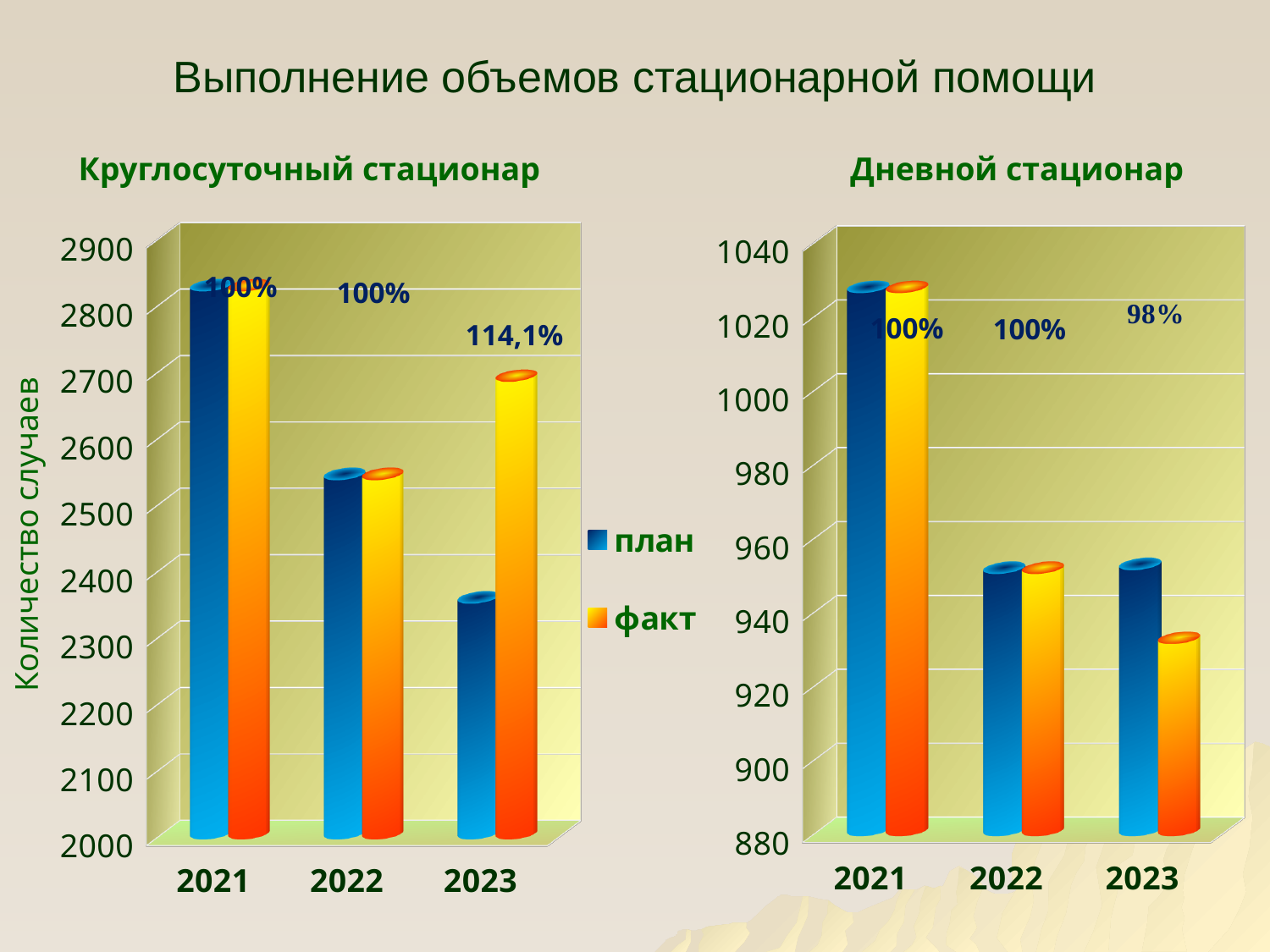
In the "Дневной стационар" chart, how many years are shown on the x axis? 3 In the "Круглосуточный стационар" chart, for 2023, which is larger: план or факт? факт What kind of chart is the "Круглосуточный стационар" chart? bar chart In the "Круглосуточный стационар" chart, which year has the lowest план value? 2023 In the "Круглосуточный стационар" chart, does the план value rise or fall from 2021 to 2023? fall In the "Дневной стационар" chart, which year has the lowest факт value? 2023 In the "Круглосуточный стационар" chart, is the план value for 2023 greater or less than 2400? less In the "Круглосуточный стационар" chart, which year has the highest план value? 2021 In the "Круглосуточный стационар" chart, what percentage is written above the 2023 bars? 114,1% In the "Дневной стационар" chart, for 2023, which is larger: план or факт? план How many series does the legend list for the charts on the slide? 2 In the "Дневной стационар" chart, is the факт value for 2023 greater or less than 940? less